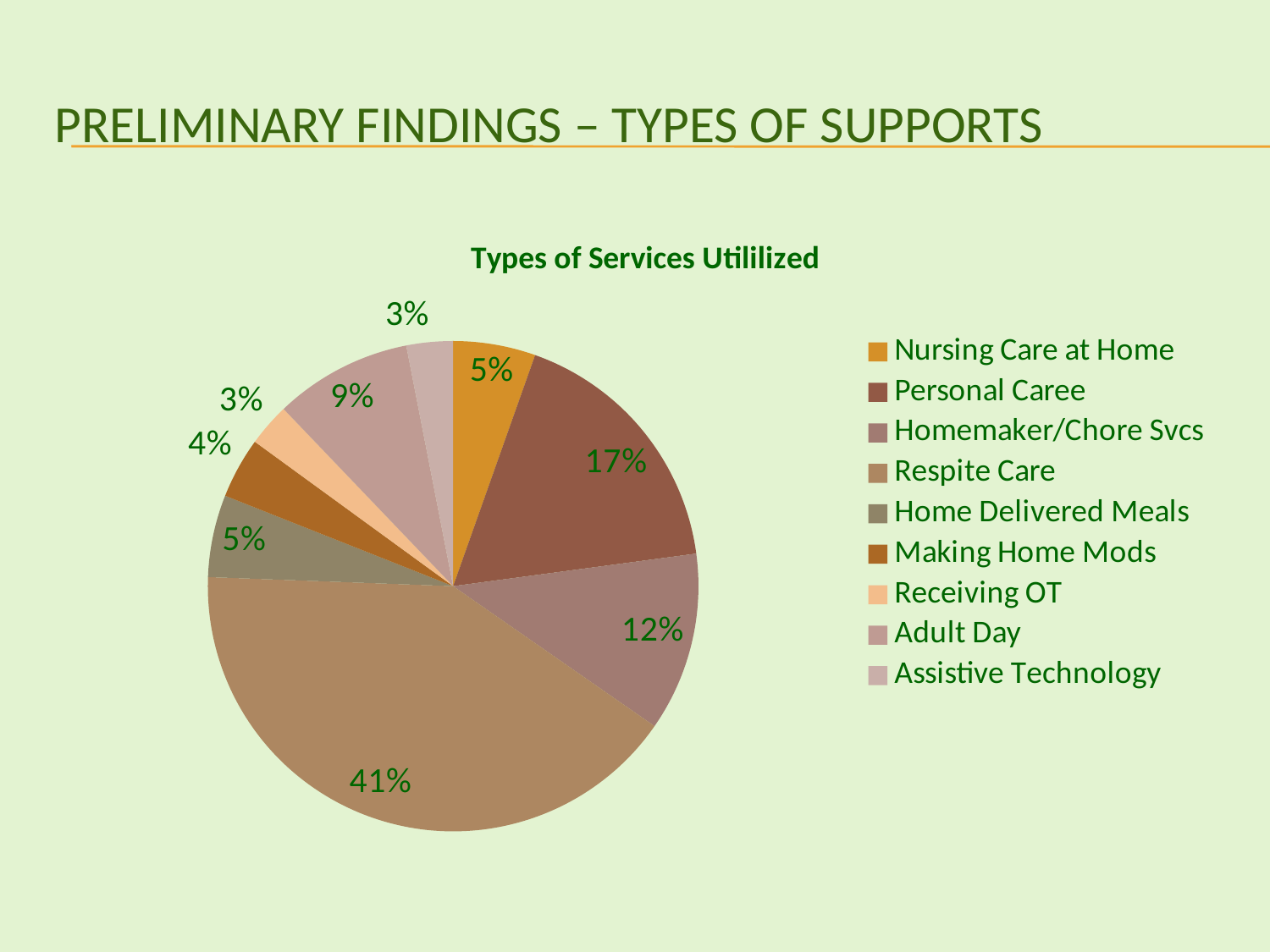
What share of the pie is Homemaker/Chore Svcs? 12% How many categories does the legend list? 9 What share of the pie is Making Home Mods? 4% What share of the pie is Personal Caree? 17% Which category has the largest slice of the pie? Respite Care What kind of chart is shown on the slide? pie chart What is the difference in percentage points between Respite Care and Personal Caree? 24 Which is larger, the slice for Personal Caree or the slice for Homemaker/Chore Svcs? Personal Caree What colour is the slice for Nursing Care at Home? orange What is the title of the chart? Types of Services Utililized